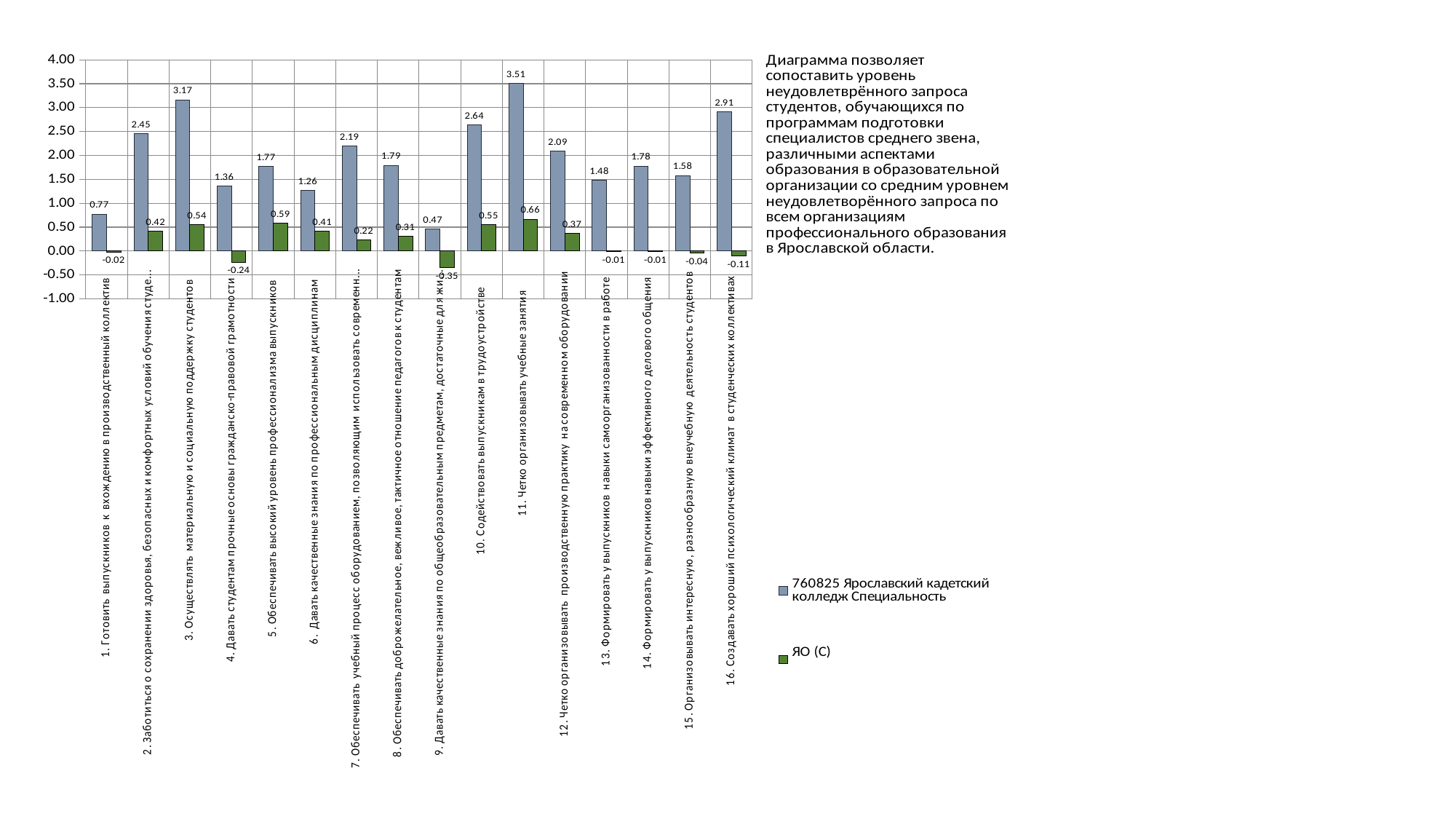
Which category has the highest value for the series '760825 Ярославский кадетский колледж Специальность'? 11. Четко организовывать учебные занятия Which is larger for '760825 Ярославский кадетский колледж Специальность': category '2. Заботиться о сохранении здоровья' or category '16. Создавать хороший психологический климат в студенческих коллективах'? 16. Создавать хороший психологический климат в студенческих коллективах How many series does the legend list? 2 How many categories are plotted along the x axis? 16 What is the value for '760825 Ярославский кадетский колледж Специальность' in category '11. Четко организовывать учебные занятия'? 3.51 What type of chart is shown on the slide? bar chart What is the value for 'ЯО (С)' in category '9. Давать качественные знания по общеобразовательным предметам'? -0.35 Which category has the lowest value for the series '760825 Ярославский кадетский колледж Специальность'? 9. Давать качественные знания по общеобразовательным предметам What is the value for '760825 Ярославский кадетский колледж Специальность' in category '3. Осуществлять материальную и социальную поддержку студентов'? 3.17 Which category has the highest value for the series 'ЯО (С)'? 11. Четко организовывать учебные занятия What is the difference between the two series in category '10. Содействовать выпускникам в трудоустройстве'? 2.09 What colour are the bars for the series 'ЯО (С)'? green